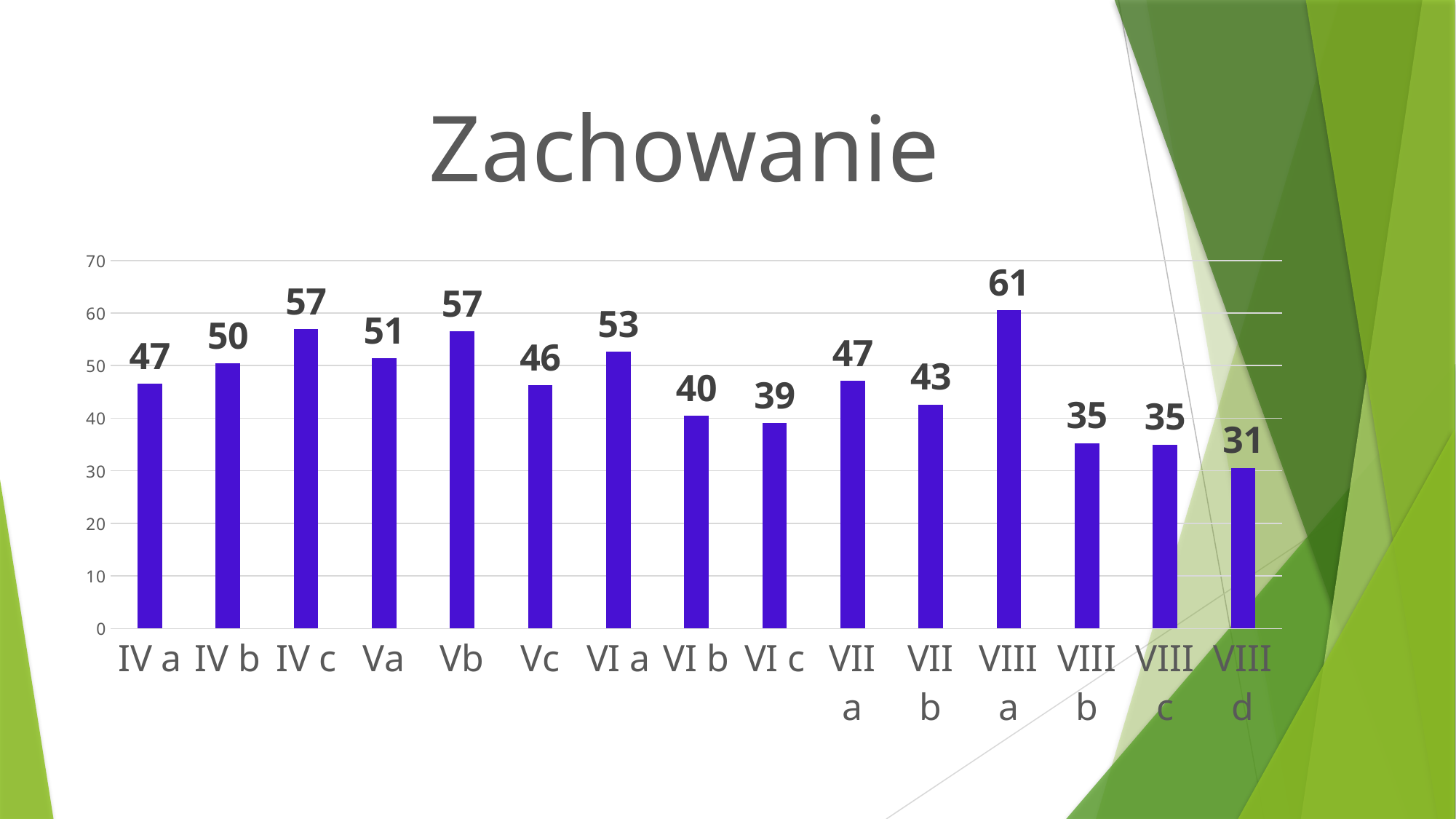
How many categories are shown on the x axis? 15 Which category has the lowest value? VIII d What is the title of the chart? Zachowanie What kind of chart is shown on the slide? bar chart What is the difference between the values for VIII a and VIII d? 30 What is the value for IV c? 57 Which category has the highest value? VIII a Is the value for VIII b greater or less than 40? less What is the value for VIII d? 31 Which is larger, the value for VI a or the value for VII b? VI a What is the difference between the values for Vb and Vc? 11 What is the value for VI b? 40